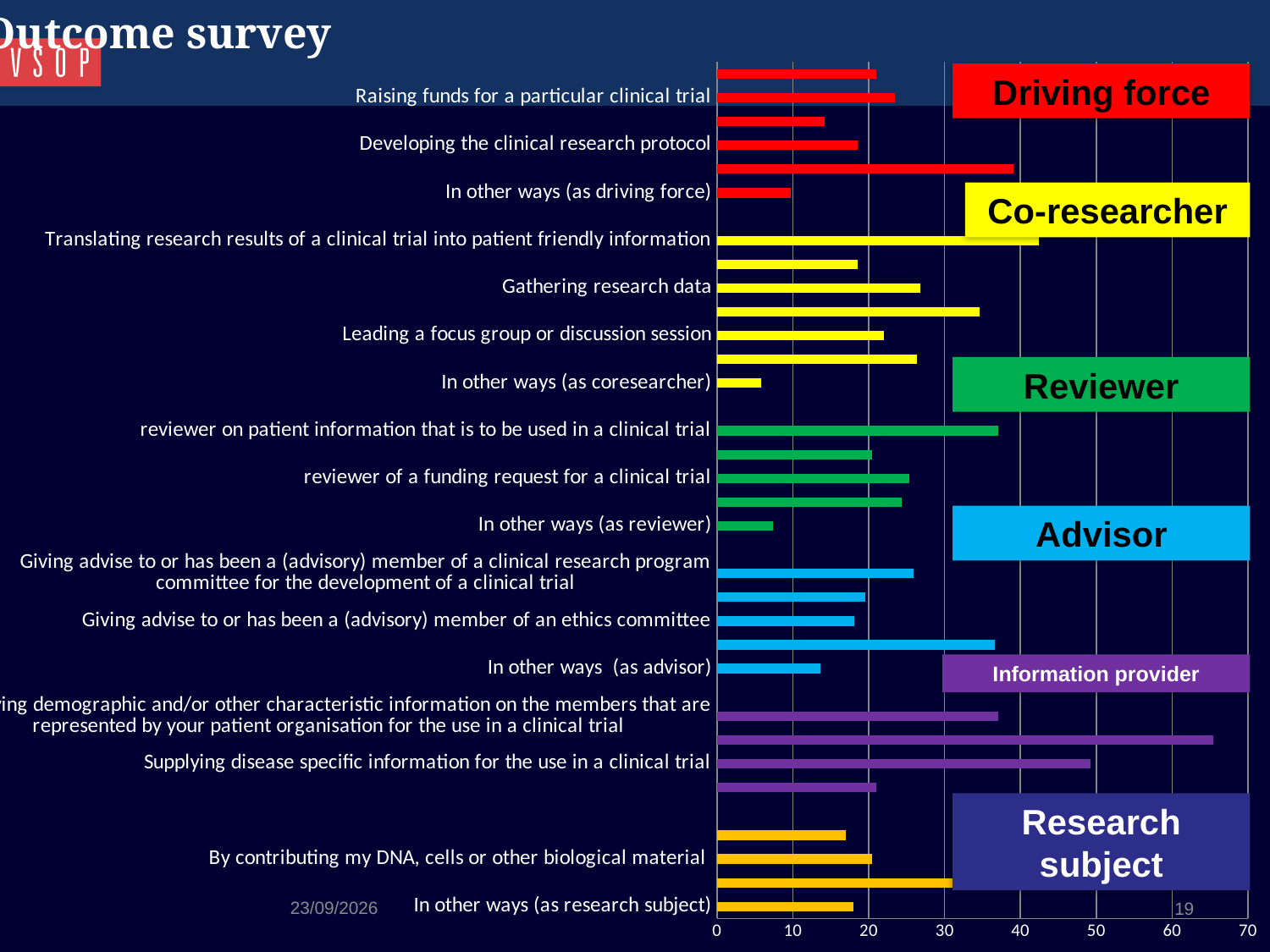
Which has the larger value: 'Supplying disease specific information for the use in a clinical trial' or 'By contributing my DNA, cells or other biological material'? Supplying disease specific information for the use in a clinical trial Is the value for 'Gathering research data' greater or less than 20? greater Which has the larger value: 'Translating research results of a clinical trial into patient friendly information' or 'Gathering research data'? Translating research results of a clinical trial into patient friendly information What colour are the bars in the 'Driving force' group? red Which has the larger value: 'reviewer on patient information that is to be used in a clinical trial' or 'reviewer of a funding request for a clinical trial'? reviewer on patient information that is to be used in a clinical trial Is the value for 'reviewer on patient information that is to be used in a clinical trial' greater or less than 30? greater Is the value for 'In other ways (as coresearcher)' greater or less than 10? less What kind of chart is shown on the slide? bar chart What is the highest value shown on the horizontal axis of the chart? 70